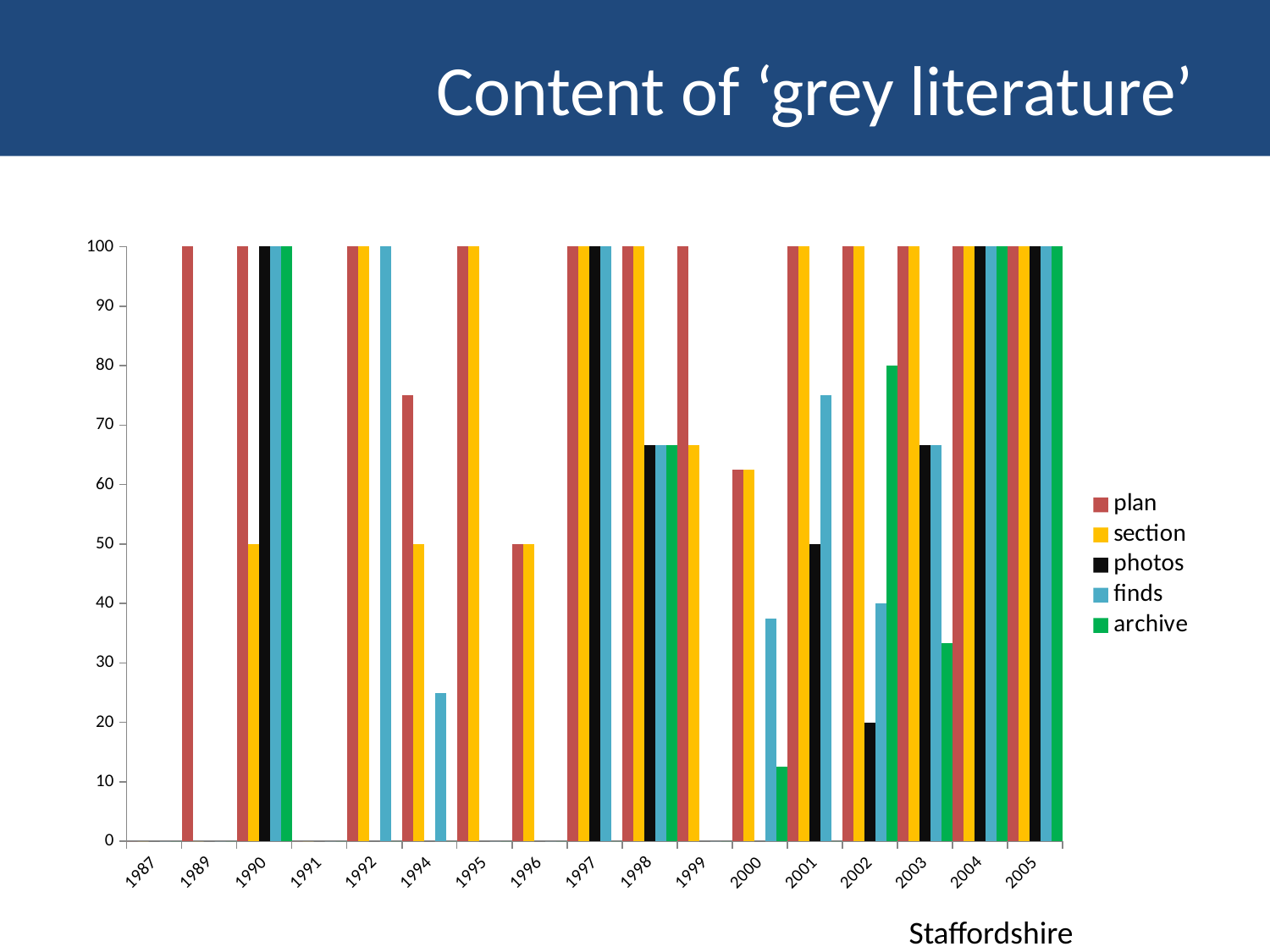
What is the difference between the archive value and the finds value in 2002? 40 Is the value for plan in 1994 greater or less than 70? greater Which is larger in 2002, the value for archive or the value for finds? archive Is the value for finds in 2000 greater or less than 40? less How many year categories are shown on the x axis? 17 What is the value for archive in 2002? 80 What is the value for plan in 1989? 100 What is the title of the chart slide? Content of ‘grey literature’ How many series does the legend list? 5 What is the value for photos in 2002? 20 What is the value for section in 1990? 50 What kind of chart is shown on the slide? bar chart